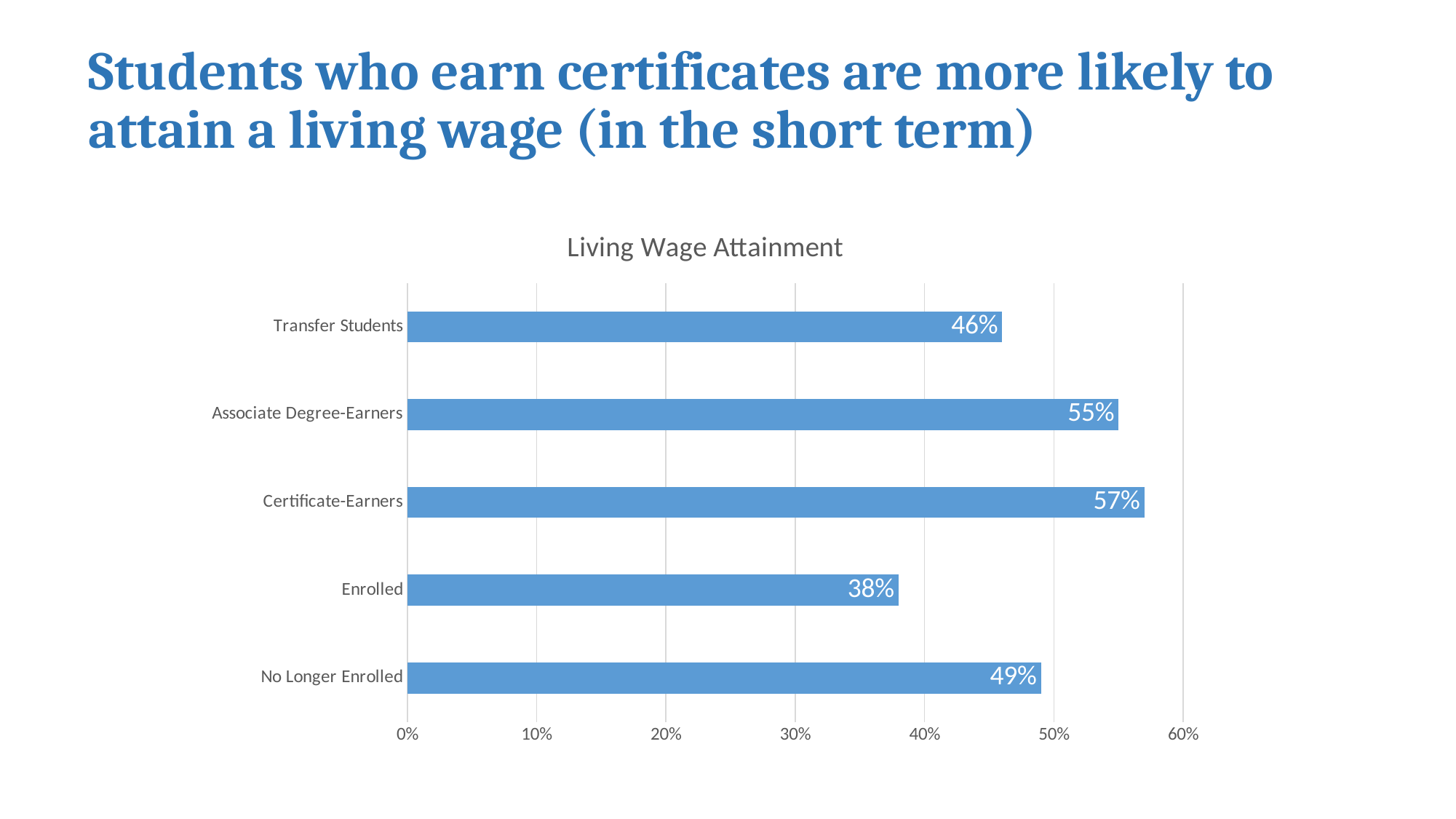
What is the living wage attainment value for Enrolled students? 38% What is the difference in living wage attainment between Certificate-Earners and Associate Degree-Earners? 2% What is the living wage attainment value for Certificate-Earners? 57% Which category has the highest living wage attainment? Certificate-Earners What type of chart is shown on the slide? Bar chart What is the living wage attainment value for Transfer Students? 46% Which has a higher living wage attainment, Transfer Students or No Longer Enrolled? No Longer Enrolled Which category has the lowest living wage attainment? Enrolled What is the difference in living wage attainment between No Longer Enrolled and Enrolled? 11% How many categories are shown in the chart? 5 Is the value for Associate Degree-Earners greater or less than 50%? greater What is the living wage attainment value for No Longer Enrolled? 49%